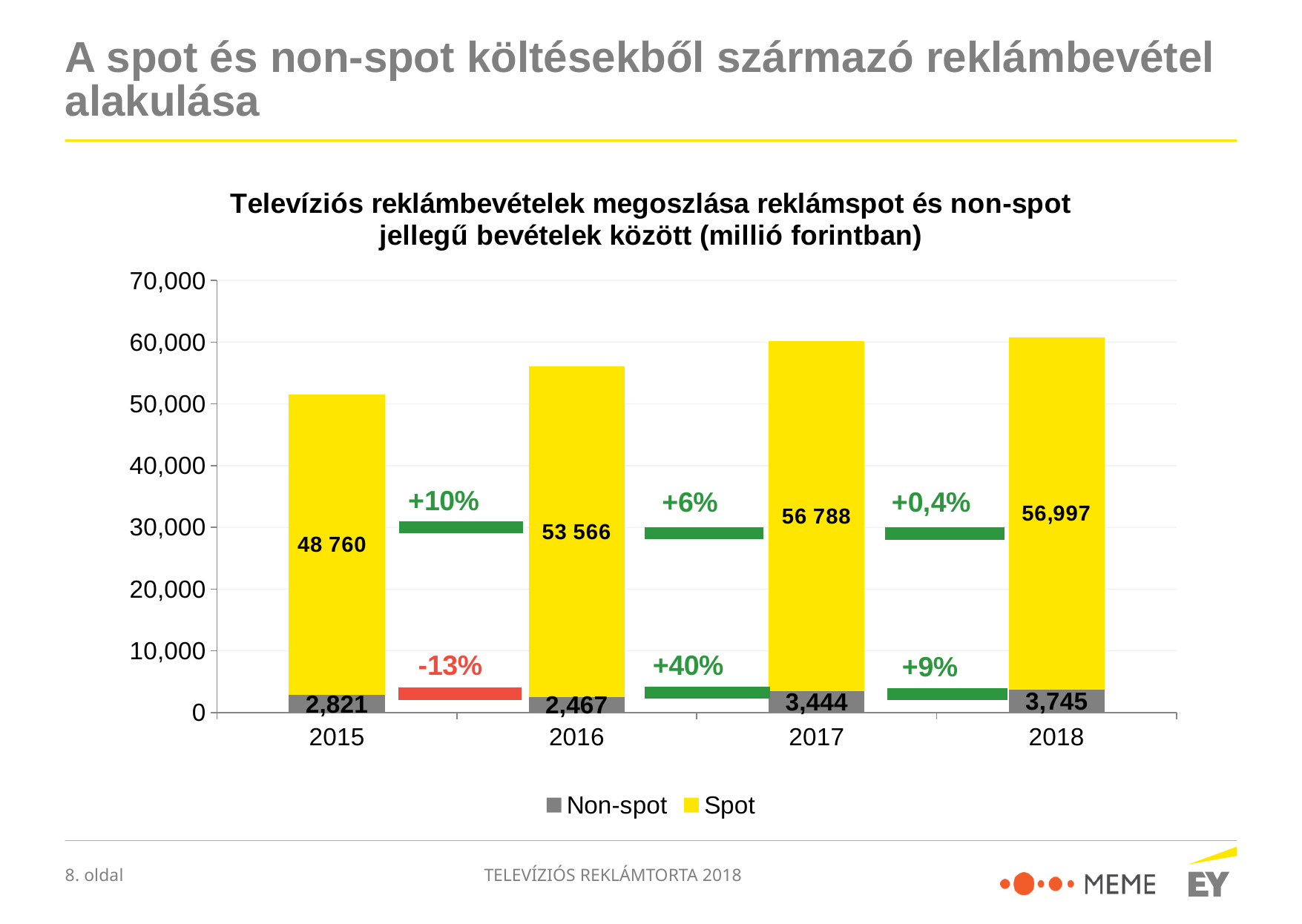
What is the total of the stacked bar for 2017? 60,232 What kind of chart is shown on the slide? stacked bar chart What percentage change is shown for Non-spot between 2015 and 2016? -13% Is the Spot value for 2015 larger or smaller than the Spot value for 2017? smaller How many years are shown on the x axis? 4 How many series does the legend list? 2 What is the Spot value for 2018? 56,997 What is the Spot value for 2016? 53 566 What is the difference between the Non-spot values for 2018 and 2015? 924 Which year has the lowest Non-spot value? 2016 What is the Non-spot value for 2017? 3,444 Which year has the highest Spot value? 2018